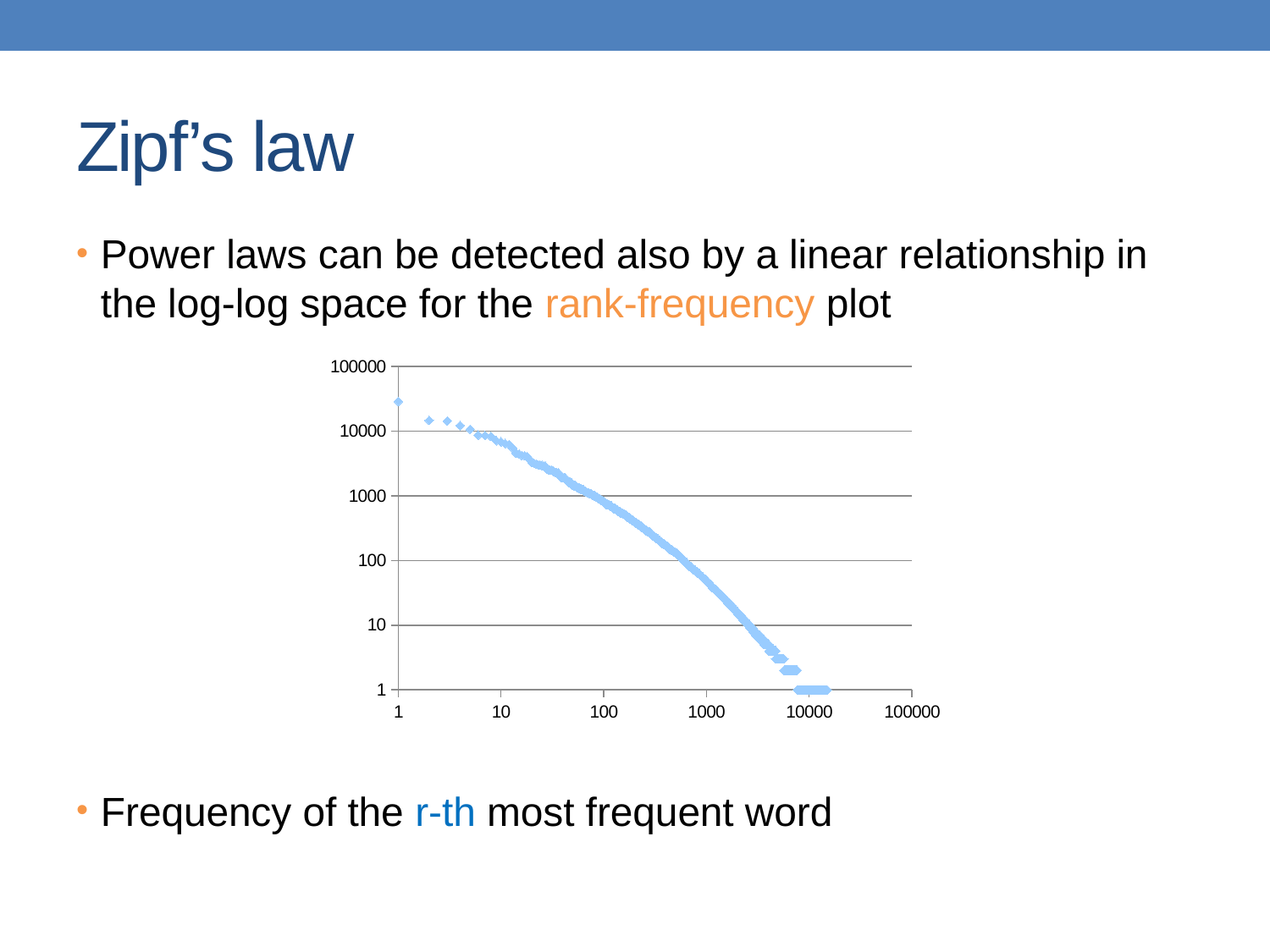
What is the lowest frequency value reached by the plotted points? 1 What kind of chart is shown on the slide? scatter chart How many tick labels are shown on the x axis? 6 Is the frequency plotted at rank 1000 greater or less than 100? less Is the frequency plotted at rank 10000 greater or less than 10? less Is the frequency plotted at rank 1 greater or less than 10000? greater How many data series are plotted in the chart? 1 Do the plotted frequency values rise or fall as rank increases along the x axis? fall At which rank is the highest frequency plotted? 1 What is the highest value labelled on the y axis? 100000 What is the highest value labelled on the x axis? 100000